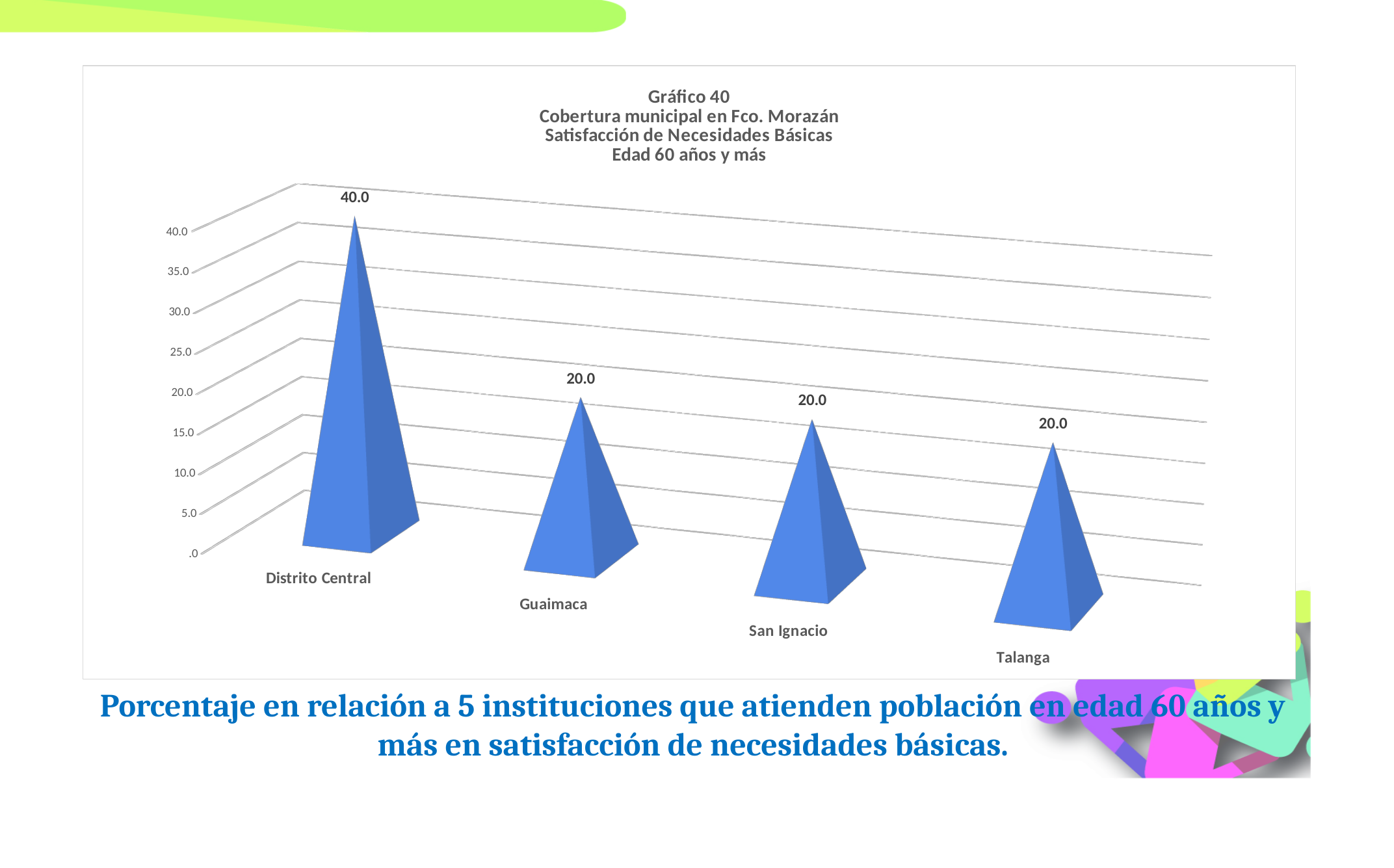
What is the value for Distrito Central? 40.0 How many municipalities are shown on the chart? 4 What is the value for San Ignacio? 20.0 What is the chart number given in the title? Gráfico 40 What is the value for Guaimaca? 20.0 What is the difference between the values for Distrito Central and Guaimaca? 20.0 Which is larger, the value for Distrito Central or the value for Talanga? Distrito Central What is the value for Talanga? 20.0 What kind of chart is this? Bar chart What is the total of the values for Guaimaca, San Ignacio and Talanga? 60.0 Which municipality has the highest value? Distrito Central Is the value for San Ignacio greater or less than 30.0? less